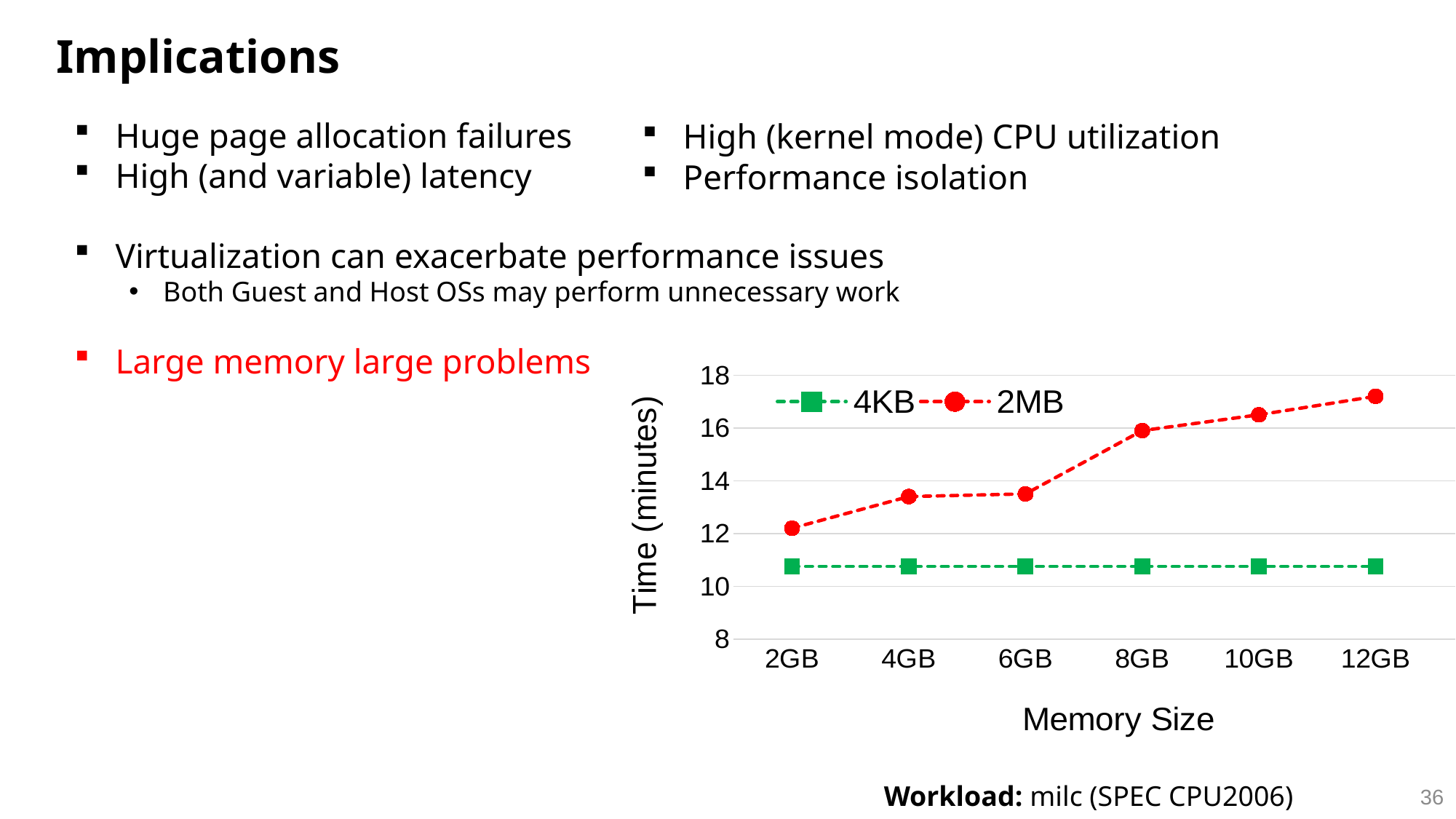
Is the time for the 4KB series at 2GB greater or less than 12 minutes? less At 8GB, which series has the larger time, 4KB or 2MB? 2MB Is the time for the 2MB series at 4GB greater or less than 14 minutes? less How many series does the chart's legend list? 2 Which memory size has the highest time for the 2MB series? 12GB Does the time for the 2MB series rise or fall as memory size increases from 2GB to 12GB? rise Which memory size has the lowest time for the 2MB series? 2GB What is the label of the chart's x axis? Memory Size What kind of chart is shown on the slide? line chart Is the time for the 2MB series at 12GB greater or less than 16 minutes? greater How many memory sizes are plotted along the x axis of the chart? 6 What is the label of the chart's y axis? Time (minutes)